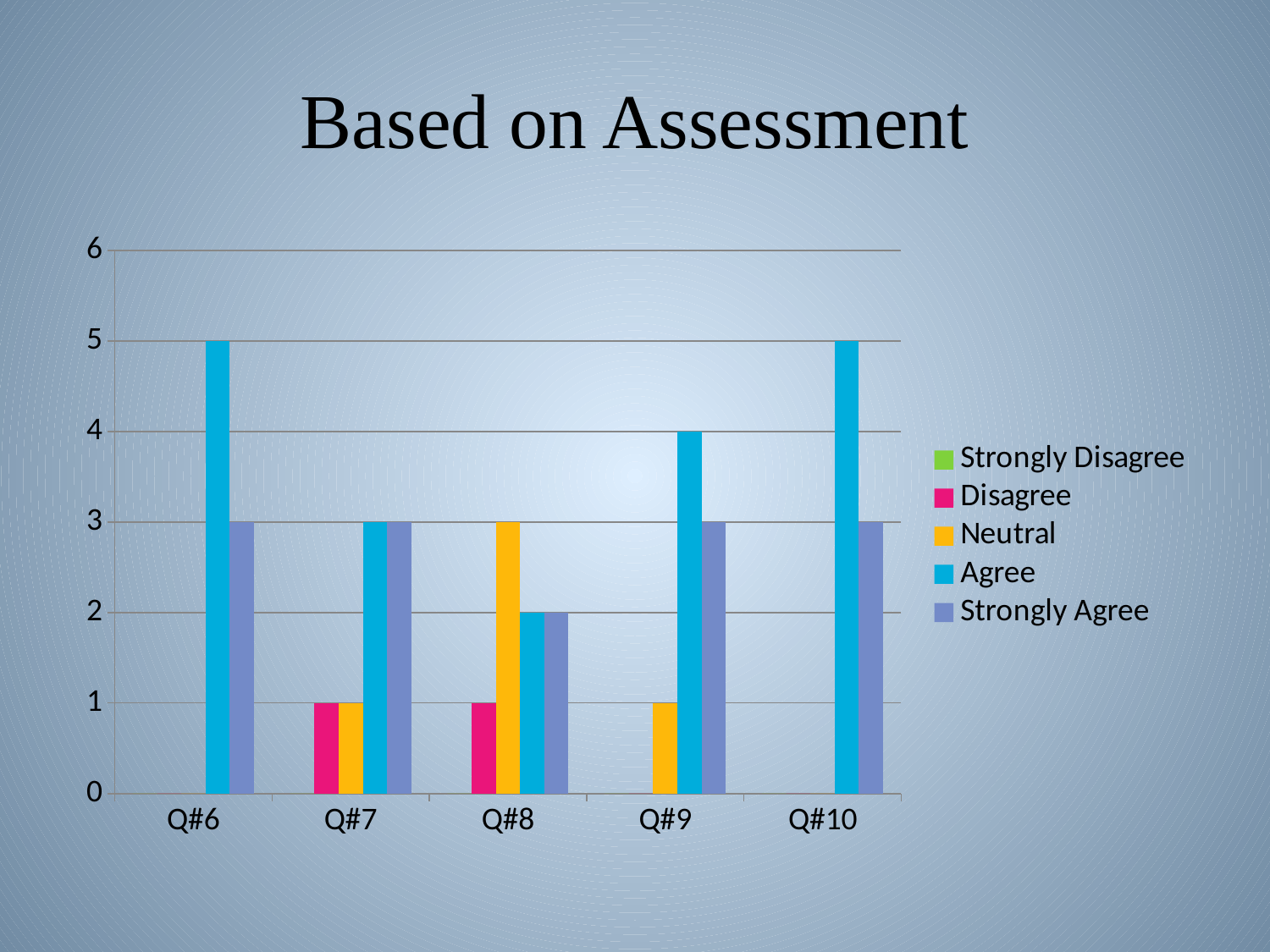
What is the Agree value for Q#6? 5 How many series does the legend list? 5 What type of chart is shown on the slide? Bar chart What is the Neutral value for Q#8? 3 Which question has the lowest Agree value? Q#8 Which is larger for Q#9: the Agree value or the Strongly Agree value? Agree What is the difference between the Agree value for Q#6 and the Agree value for Q#8? 3 Is the Agree value for Q#10 greater or less than 4? greater What is the Agree value for Q#9? 4 What is the Strongly Agree value for Q#10? 3 What is the title of the chart? Based on Assessment How many question categories are shown on the x axis? 5